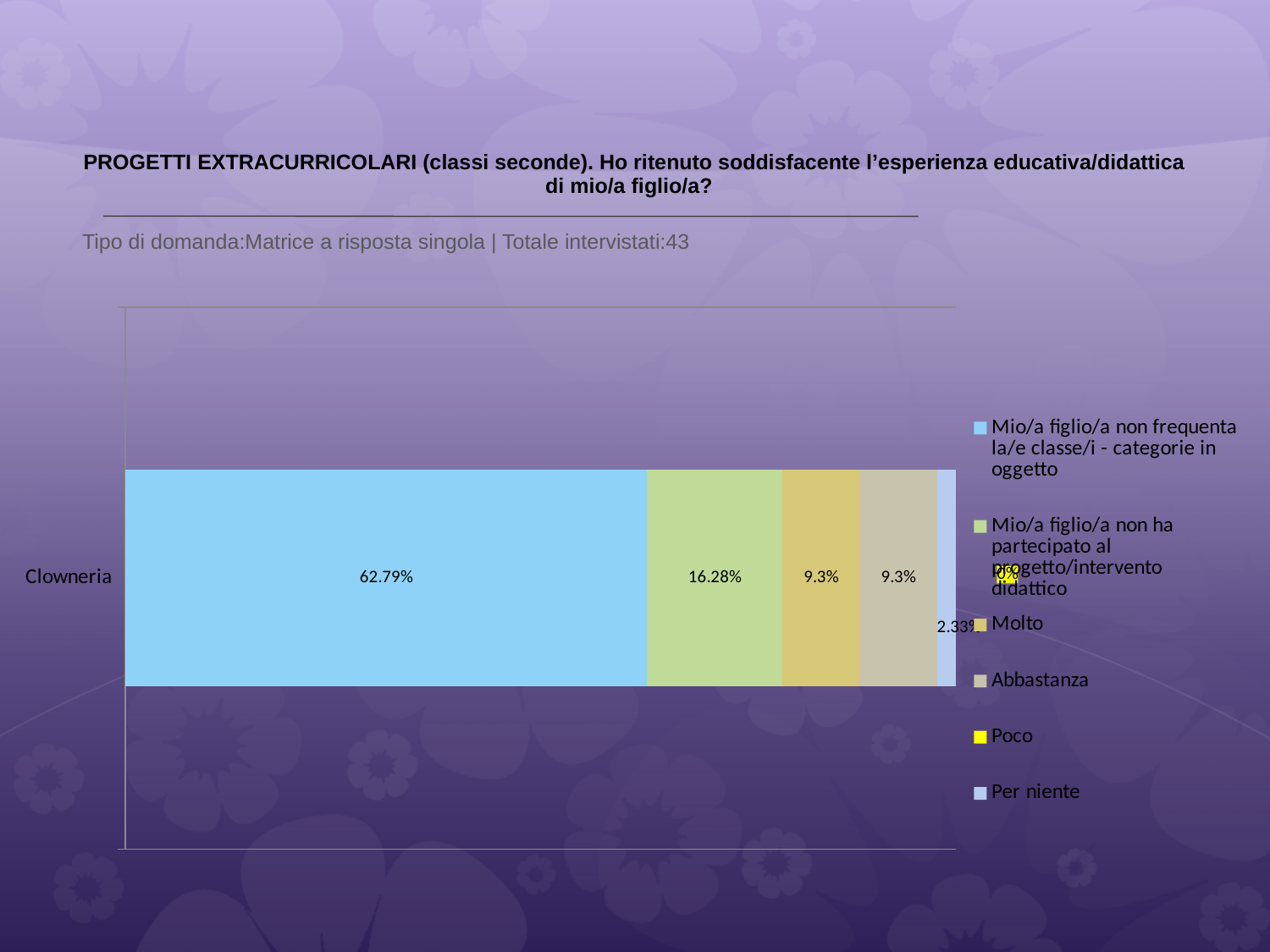
What is the value for "Poco" for Clowneria? 0% What is the value for "Mio/a figlio/a non frequenta la/e classe/i - categorie in oggetto" for Clowneria? 62.79% Which is larger for Clowneria: "Abbastanza" or "Per niente"? Abbastanza What is the value for "Per niente" for Clowneria? 2.33% How many series does the legend list? 6 What is the value for "Molto" for Clowneria? 9.3% What kind of chart is shown on the slide? stacked bar chart What is the value for "Mio/a figlio/a non ha partecipato al progetto/intervento didattico" for Clowneria? 16.28% Which series has the highest value for Clowneria? Mio/a figlio/a non frequenta la/e classe/i - categorie in oggetto Which series has the lowest value for Clowneria? Poco How many categories are shown on the chart? 1 What is the difference between the "Mio/a figlio/a non frequenta" value and the "Mio/a figlio/a non ha partecipato" value for Clowneria? 46.51%